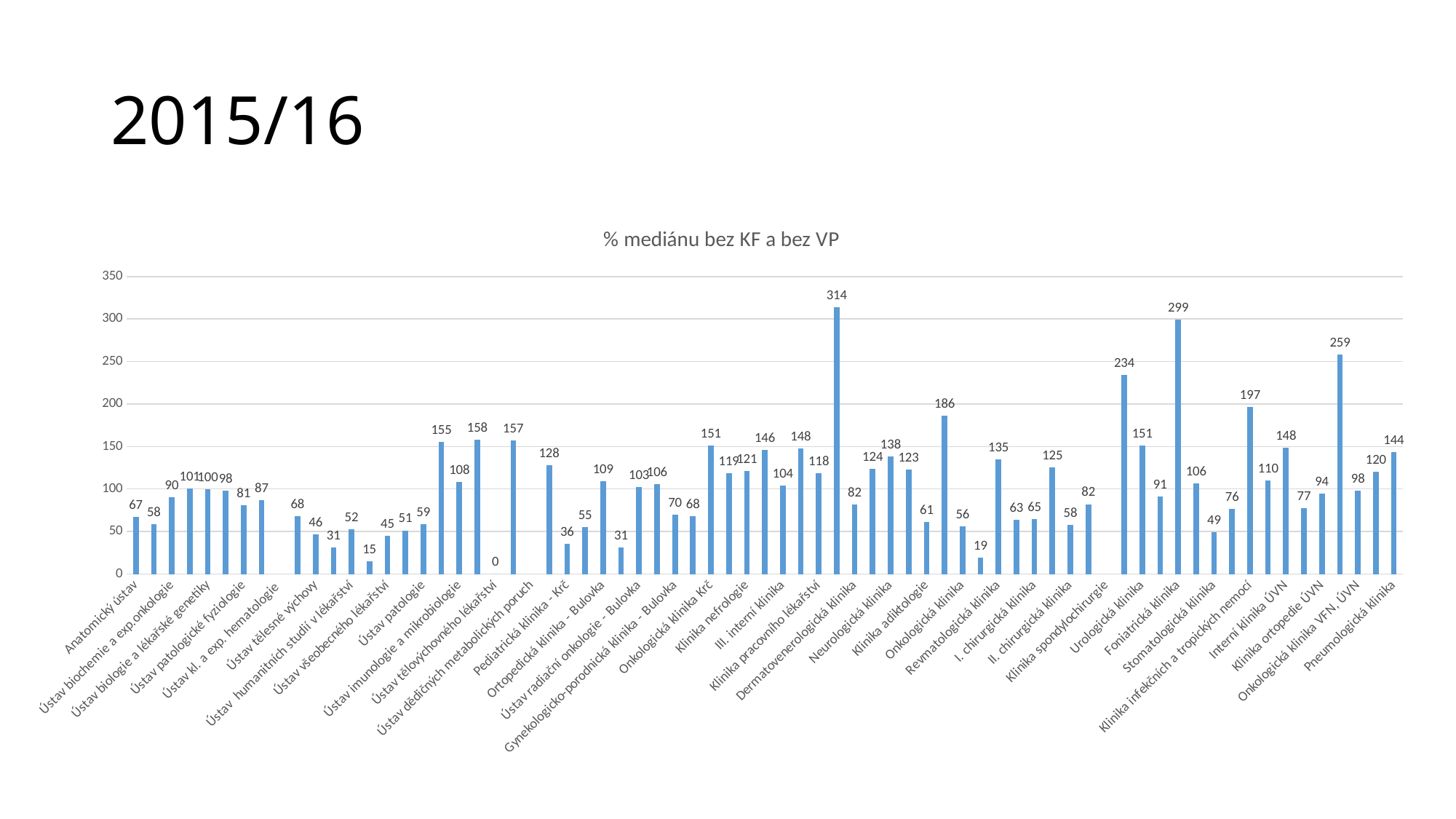
What is the difference between the two tallest bars in the chart (314 and 299)? 15 What is the lowest value labelled in the chart? 0 How many bars in the chart have a value above 250? 3 How many bars in the chart have a value above 200? 4 What is the highest tick value on the vertical axis? 350 What kind of chart is shown on the slide? bar chart Which is larger, the bar labelled 259 or the bar labelled 234? 259 What is the title of the chart? % mediánu bez KF a bez VP What is the highest value shown in the chart? 314 What is the value of the second tallest bar in the chart? 299